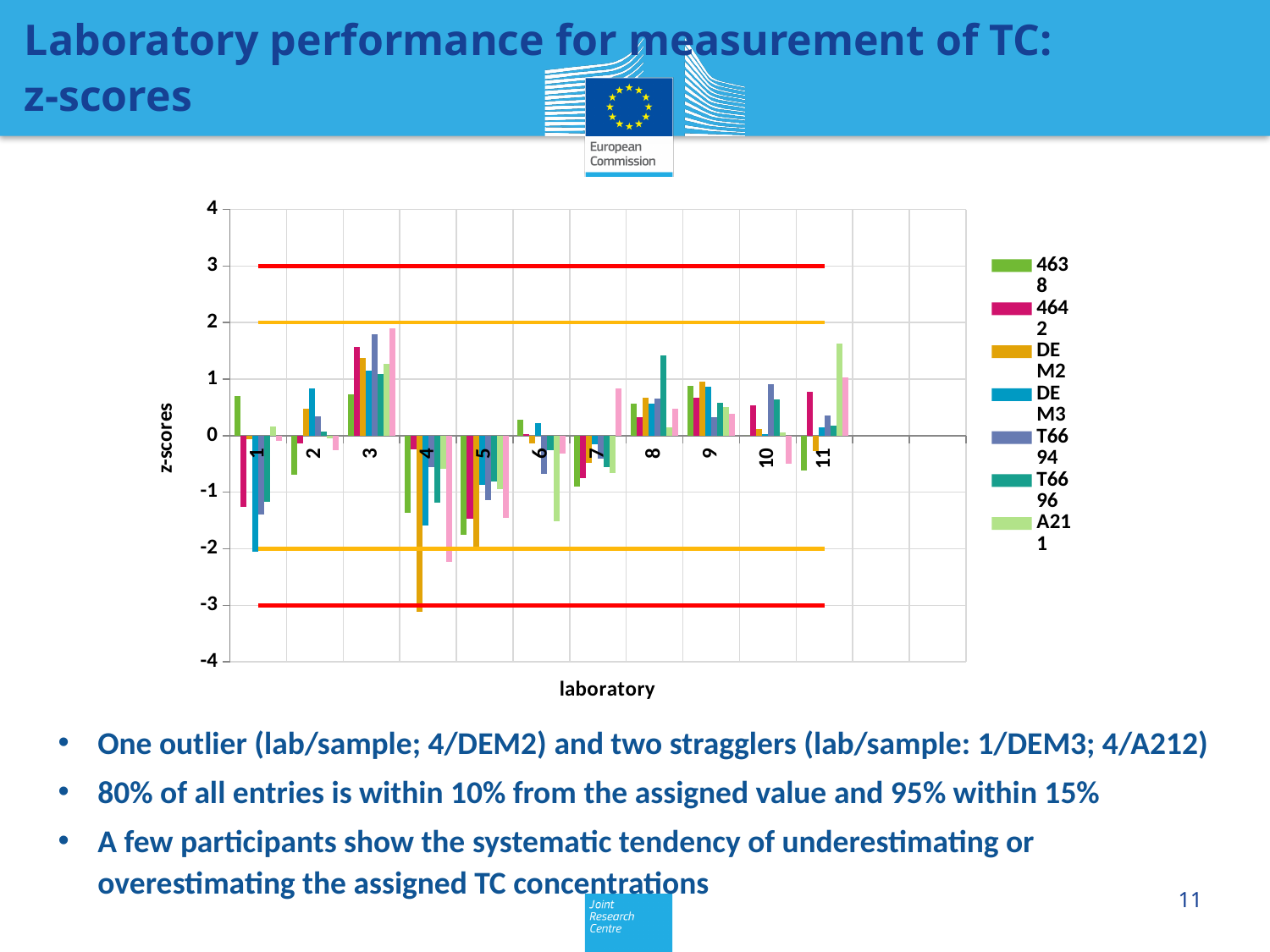
What is the title of the vertical axis of the chart? z-scores At laboratory 3, which series has the larger z-score, 4638 or 4642? 4642 Is the z-score for T6696 at laboratory 8 greater or less than 1? greater Which laboratory has the highest z-score in the chart? 3 Is the z-score for A211 at laboratory 11 greater or less than 1? greater Is the z-score for DEM2 at laboratory 4 greater or less than -3? less How many laboratories are shown along the x axis of the chart? 11 What is the title of the horizontal axis of the chart? laboratory What kind of chart is shown on the slide? bar chart Which laboratory has the lowest z-score in the chart? 4 How many series does the chart legend list? 7